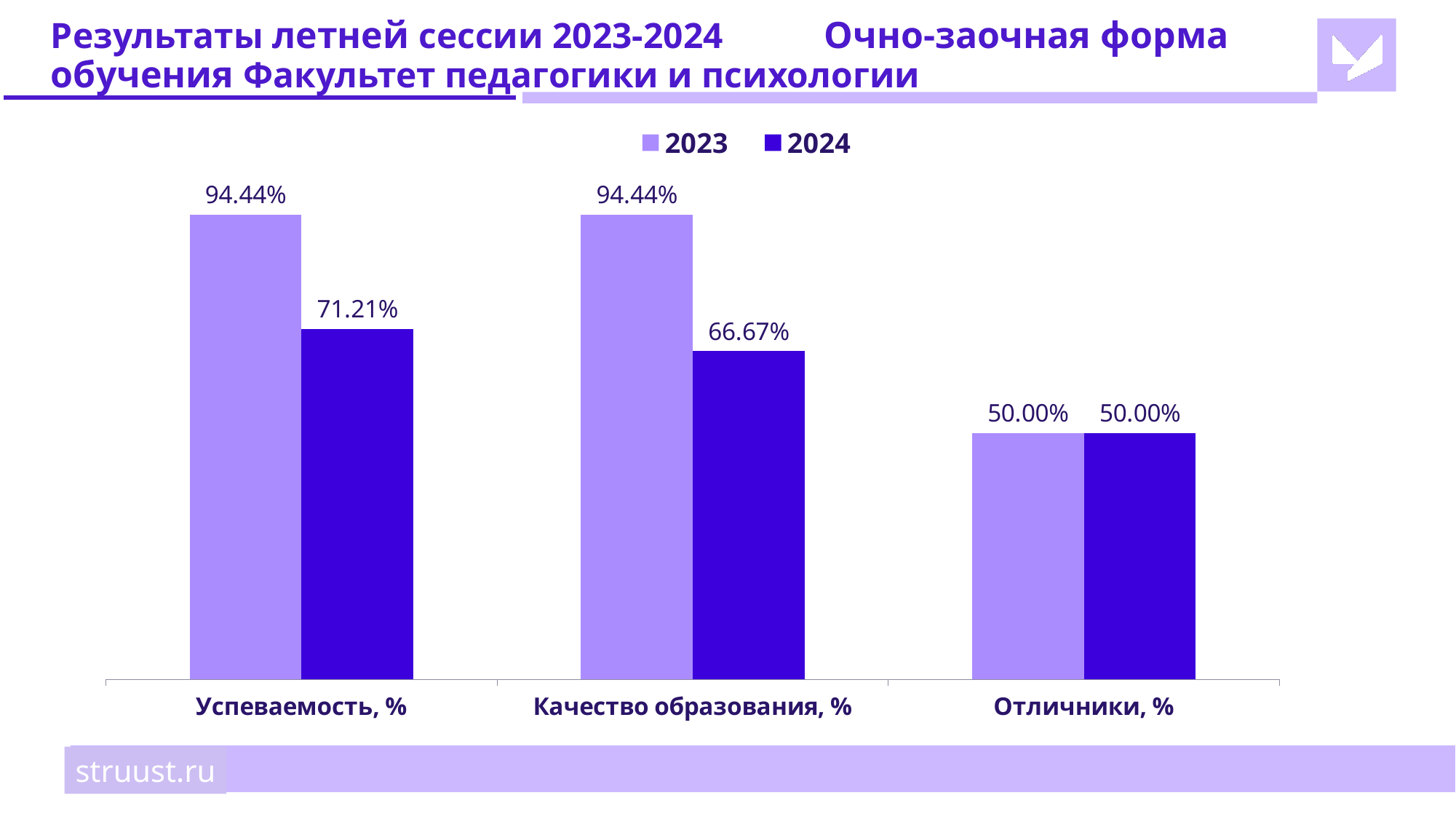
What is the 2024 value for Успеваемость, %? 71.21% What is the 2023 value for Отличники, %? 50.00% What is the difference between the 2023 and 2024 values for Успеваемость, %? 23.23% Which is larger for Качество образования, %: the 2023 value or the 2024 value? 2023 What kind of chart is shown on the slide? bar chart What is the 2023 value for Успеваемость, %? 94.44% What is the difference between the 2023 and 2024 values for Качество образования, %? 27.77% What is the 2024 value for Качество образования, %? 66.67% How many series does the legend list? 2 Which category has the lowest 2024 value? Отличники, % How many categories are shown on the x axis? 3 Which series is shown in the darker purple colour? 2024